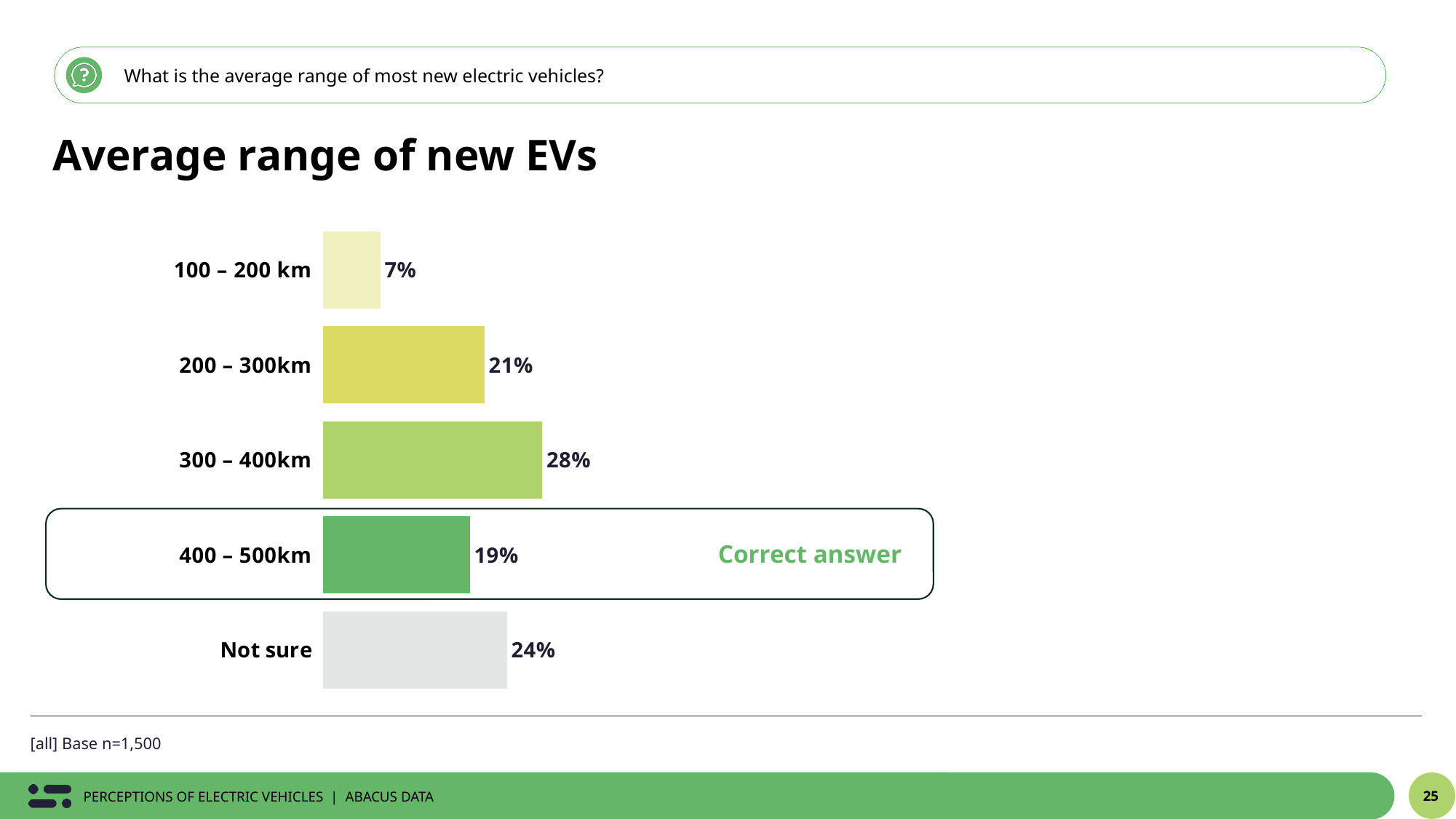
Which range category has the highest percentage of respondents? 300 – 400km What percentage of respondents chose 400 – 500km, the correct answer? 19% What percentage of respondents said the average range of new EVs is 300 – 400km? 28% What percentage of respondents answered 'Not sure' about the average range of new EVs? 24% Which range category has the lowest percentage of respondents? 100 – 200 km What is the difference in percentage points between the 300 – 400km and 400 – 500km categories? 9 What is the title of the chart? Average range of new EVs How many categories are shown in the chart? 5 Which category is marked as the correct answer on the chart? 400 – 500km What kind of chart is shown on the slide? Bar chart Which has a larger share of respondents: 200 – 300km or Not sure? Not sure What is the difference in percentage points between the 200 – 300km and 100 – 200 km categories? 14